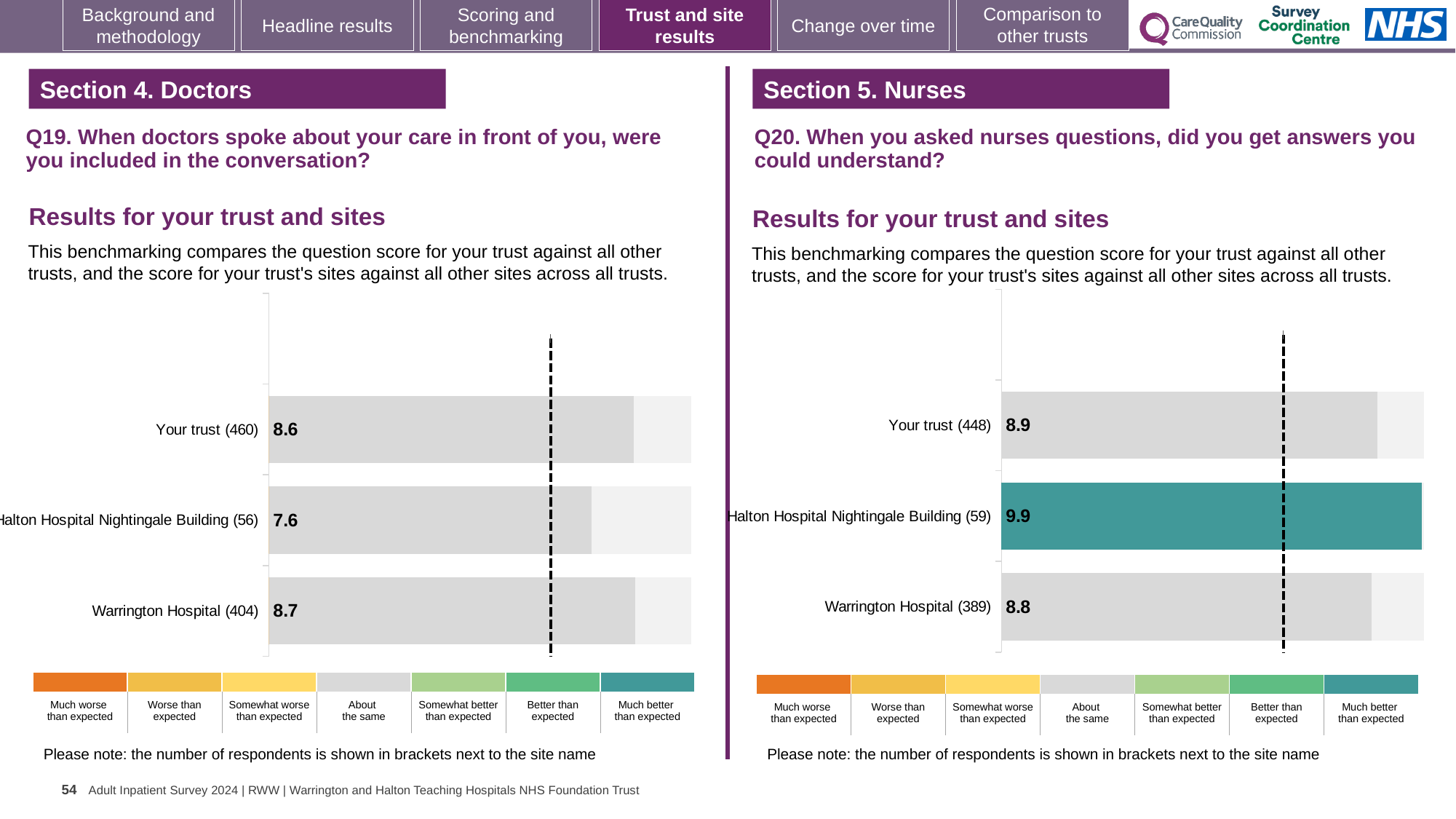
In the Q20 chart (nurses, right), which row has the highest score? Halton Hospital Nightingale Building In the Q19 chart (doctors, left), what is the score for Halton Hospital Nightingale Building? 7.6 In the Q19 chart (doctors, left), what is the score for Your trust? 8.6 In the Q20 chart (nurses, right), what is the score for Halton Hospital Nightingale Building? 9.9 Which is larger: the Your trust score in the Q19 chart or the Your trust score in the Q20 chart? Q20 chart (8.9) In the Q19 chart (doctors, left), what is the difference between the Warrington Hospital score and the Halton Hospital Nightingale Building score? 1.1 What type of chart is used on this slide to show the trust and site scores? Bar chart In the Q20 chart (nurses, right), what is the score for Warrington Hospital? 8.8 In the Q19 chart (doctors, left), how many rows (trust and sites) are plotted? 3 In the Q20 chart (nurses, right), which benchmark category does the coloured bar for Halton Hospital Nightingale Building correspond to in the legend? Much better than expected In the Q19 chart (doctors, left), which site or trust row has the lowest score? Halton Hospital Nightingale Building In the Q20 chart (nurses, right), what is the difference between the Halton Hospital Nightingale Building score and the Your trust score? 1.0